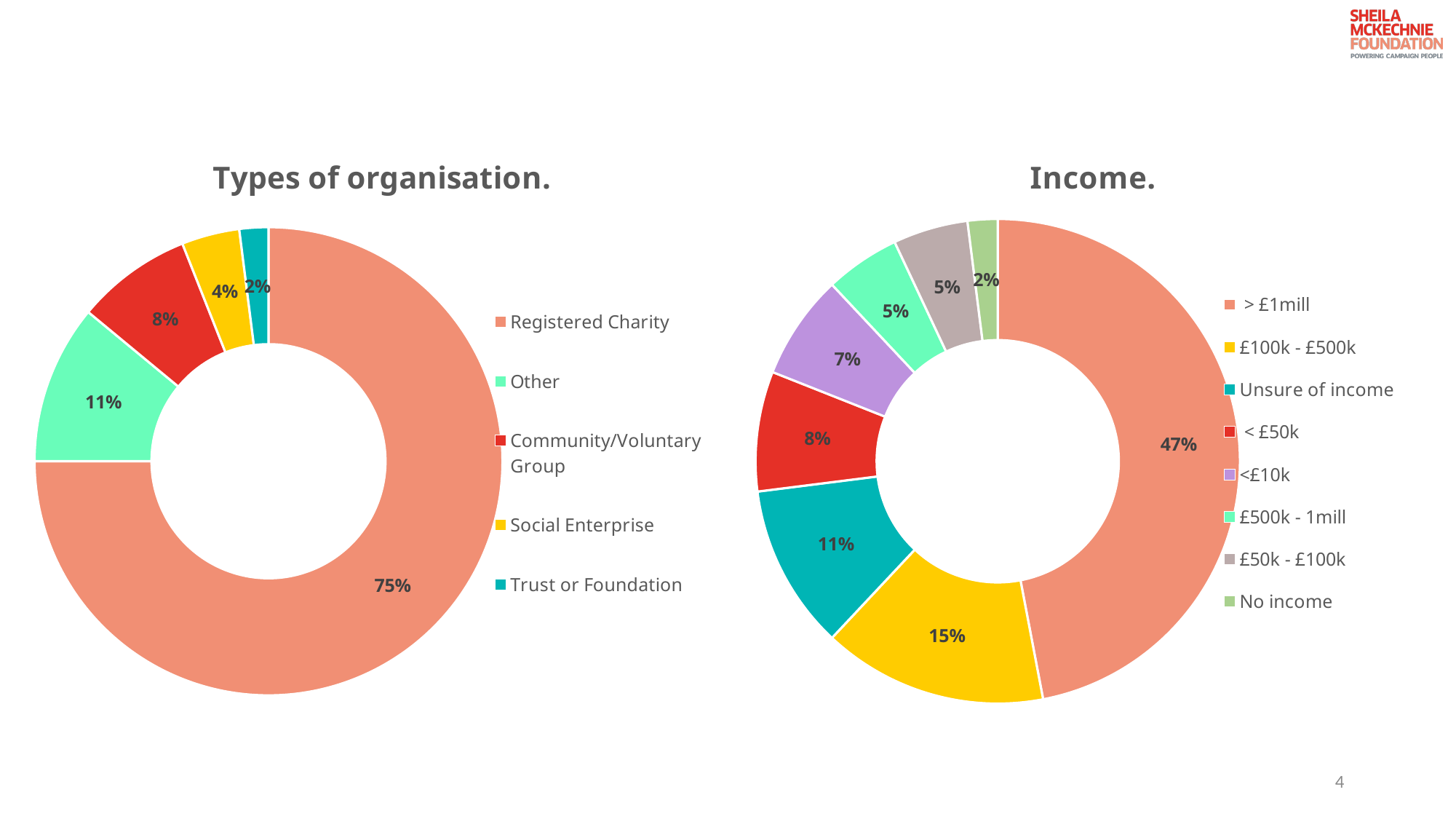
In the 'Income.' chart, what colour is the No income slice? Green In the 'Types of organisation.' chart, what is the difference between the Other share and the Community/Voluntary Group share? 3% In the 'Types of organisation.' chart, what percentage is Registered Charity? 75% In the 'Types of organisation.' chart, how many categories are shown? 5 In the 'Types of organisation.' chart, which category has the smallest share? Trust or Foundation In the 'Income.' chart, what percentage is > £1mill? 47% In the 'Income.' chart, which is larger: £100k - £500k or < £50k? £100k - £500k In the 'Income.' chart, what percentage is Unsure of income? 11% What kind of chart is the 'Income.' chart? Doughnut (pie) chart In the 'Income.' chart, how many categories does the legend list? 8 In the 'Types of organisation.' chart, what percentage is Social Enterprise? 4% In the 'Income.' chart, which category has the largest share? > £1mill